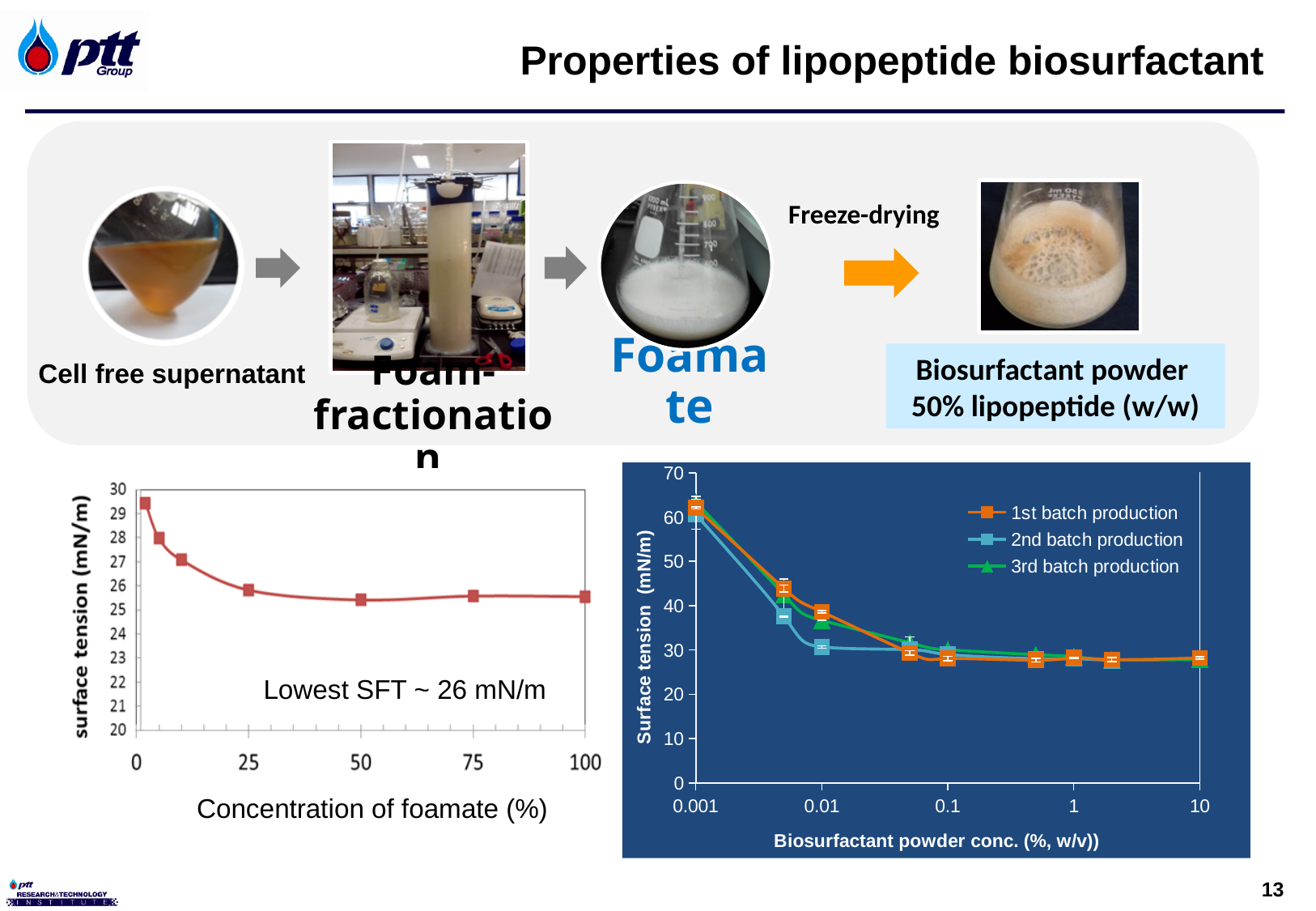
In the right chart, does surface tension rise or fall as biosurfactant powder concentration increases? fall How many series does the legend of the right chart (surface tension vs biosurfactant powder conc.) list? 3 In the left chart, is the surface tension at the lowest plotted concentration greater or less than 28 mN/m? greater What is the x-axis title of the left chart? Concentration of foamate (%) In the right chart, at 0.01% concentration, which has the higher surface tension: 1st batch production or 2nd batch production? 1st batch production In the left chart, does surface tension rise or fall as the concentration of foamate increases? fall In the right chart, is the surface tension of the 1st batch production at 0.001% greater or less than 50 mN/m? greater What kind of chart is the right chart (surface tension vs biosurfactant powder conc.)? line chart In the left chart, is the surface tension at 50% foamate concentration greater or less than 26 mN/m? less How many data points are plotted in the left chart? 7 What kind of chart is the left chart (surface tension vs concentration of foamate)? line chart